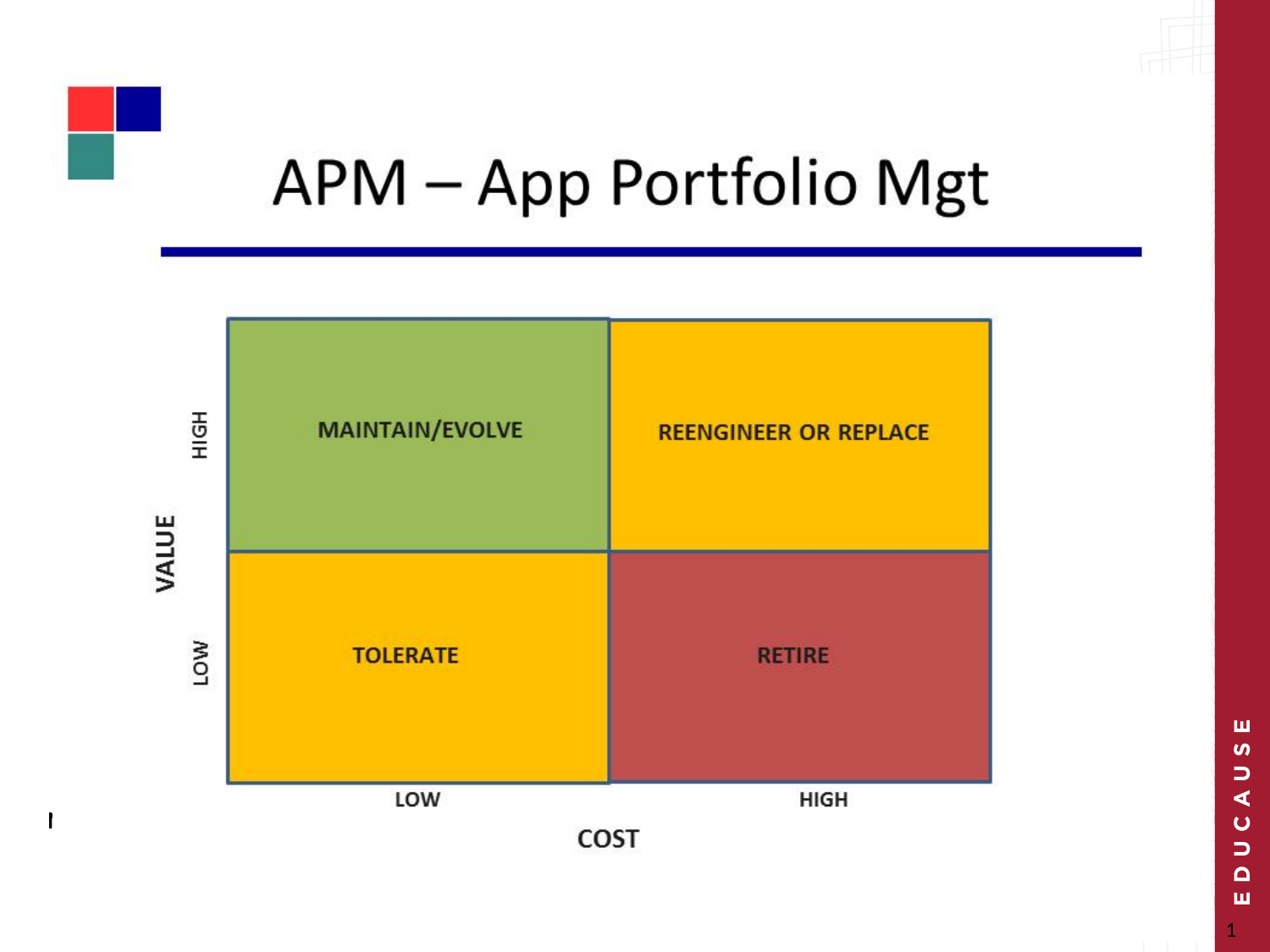
What is the label of the horizontal axis of the matrix? COST How many quadrants does the matrix contain? 4 What is the label of the vertical axis of the matrix? VALUE Which quadrant corresponds to low value and high cost? RETIRE What kind of chart is shown on the slide? A 2x2 quadrant matrix Which quadrant corresponds to low value and low cost? TOLERATE Which quadrant corresponds to high value and low cost? MAINTAIN/EVOLVE Which quadrant corresponds to high value and high cost? REENGINEER OR REPLACE